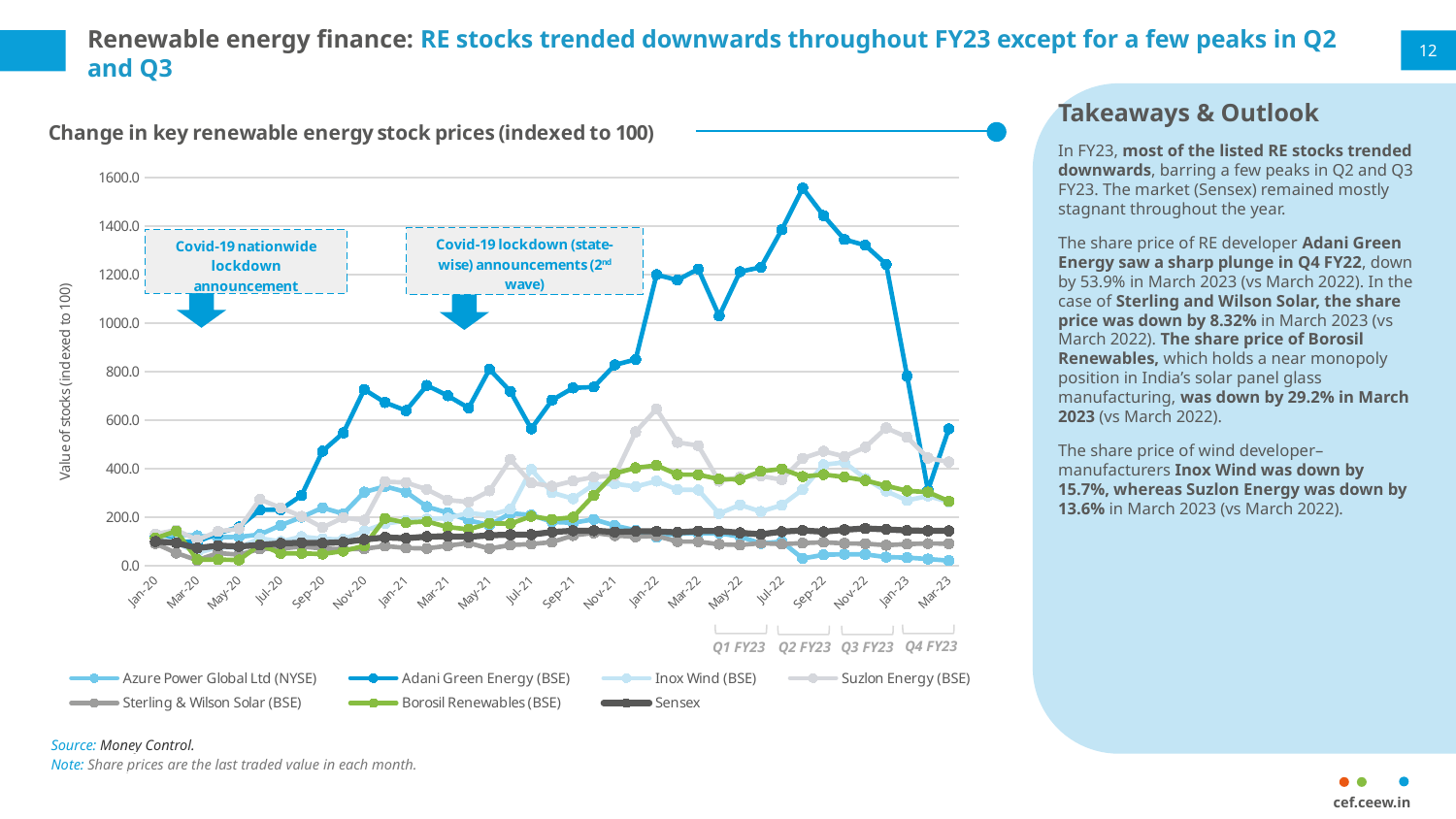
Is the value for Adani Green Energy (BSE) at its peak around Aug-22 greater or less than 1400? greater What type of chart is shown on the slide? Line chart What is the title of the chart? Change in key renewable energy stock prices (indexed to 100) Which series reaches the highest value on the chart? Adani Green Energy (BSE) How many series does the legend of the chart list? 7 Is the value for Adani Green Energy (BSE) in Jan-22 greater or less than 1000? greater Is the value for Inox Wind (BSE) in Mar-23 greater or less than 200? greater What is the label of the vertical axis of the chart? Value of stocks (indexed to 100) Does the value for Adani Green Energy (BSE) rise or fall between Sep-22 and Feb-23? Fall Which is larger in Aug-22, the value for Adani Green Energy (BSE) or the value for Sensex? Adani Green Energy (BSE) How many FY23 quarter labels (Q1 FY23 to Q4 FY23) are marked below the x axis? 4